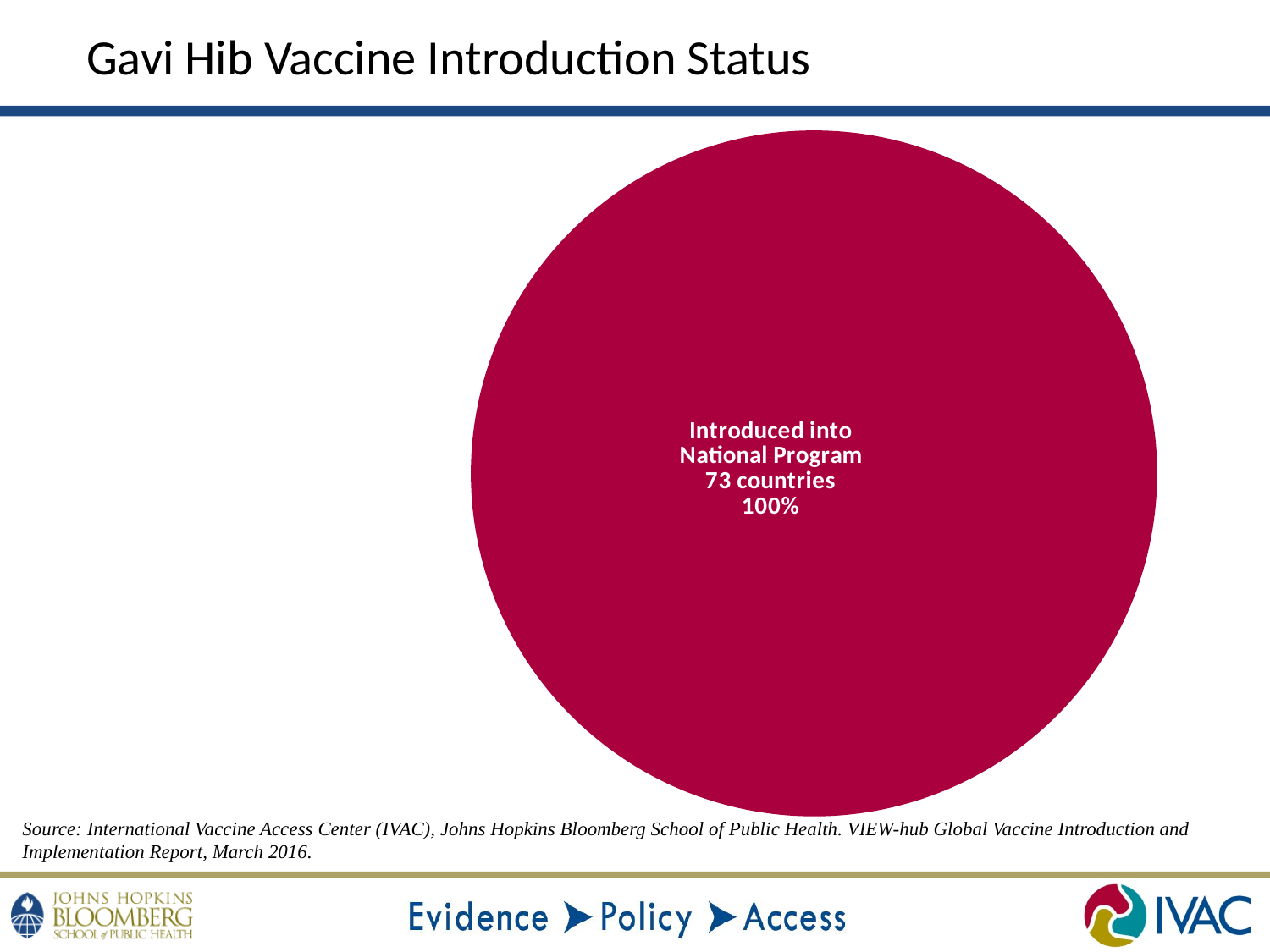
What colour is the 'Introduced into National Program' slice? red What share of the pie does the 'Introduced into National Program' slice represent? 100% How many slices does the pie chart have? 1 What kind of chart is shown on the slide? pie chart What is the title of the slide containing the pie chart? Gavi Hib Vaccine Introduction Status Is the number of countries that introduced the vaccine into their national program greater or less than 50? greater How many countries are shown as having introduced the Hib vaccine into their national program? 73 countries